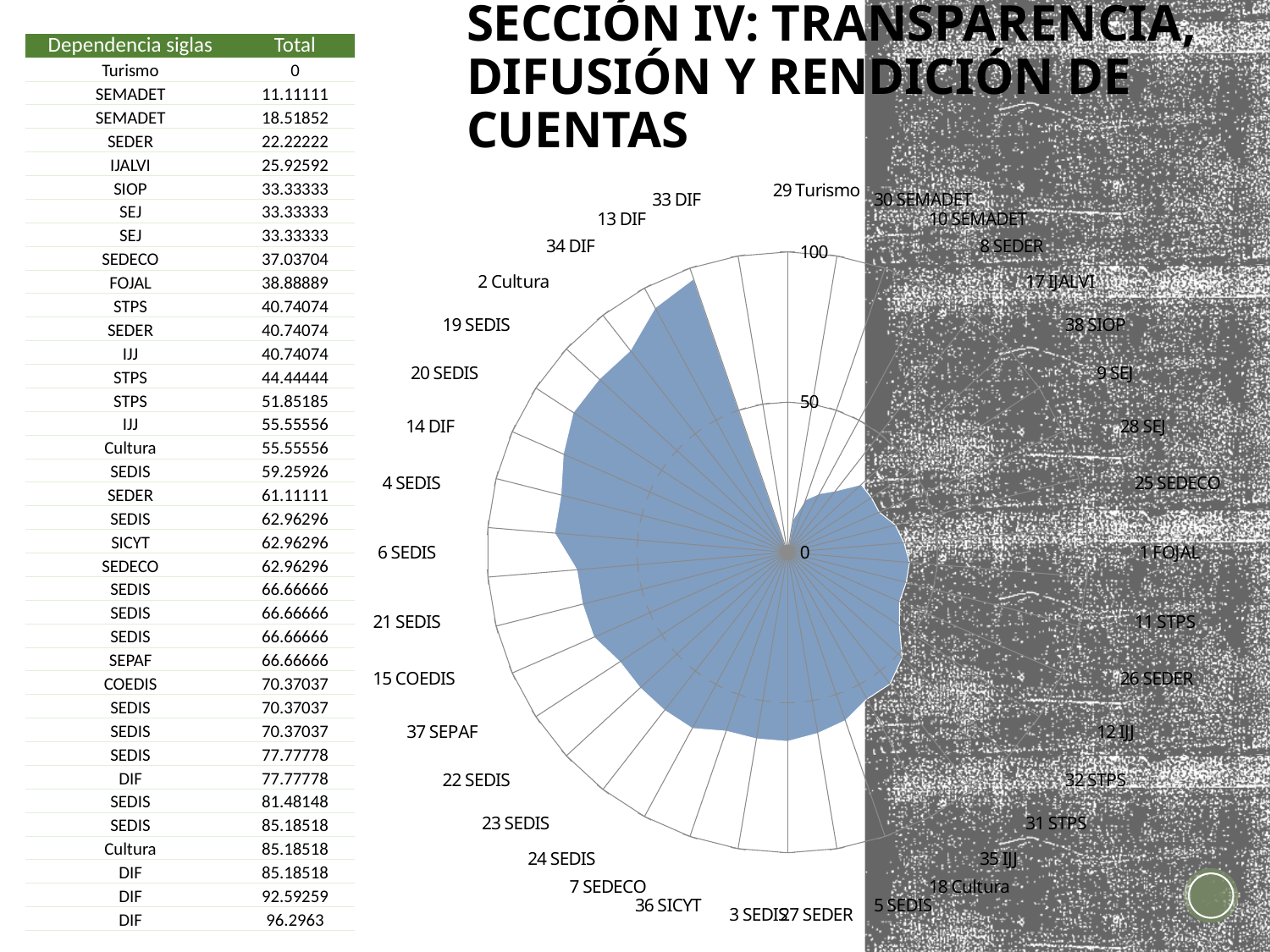
Is the value for 37 SEPAF greater or less than 50? greater Which has the larger value, 29 Turismo or 13 DIF? 13 DIF Is the value for 30 SEMADET greater or less than 50? less What is the highest value shown on the radial axis of the chart? 100 Is the value for 29 Turismo greater or less than 50? less Which category has the lowest value on the radar chart? 29 Turismo Which has the larger value, 14 DIF or 8 SEDER? 14 DIF What kind of chart is shown on the slide? radar chart How many categories are plotted on the radar chart? 37